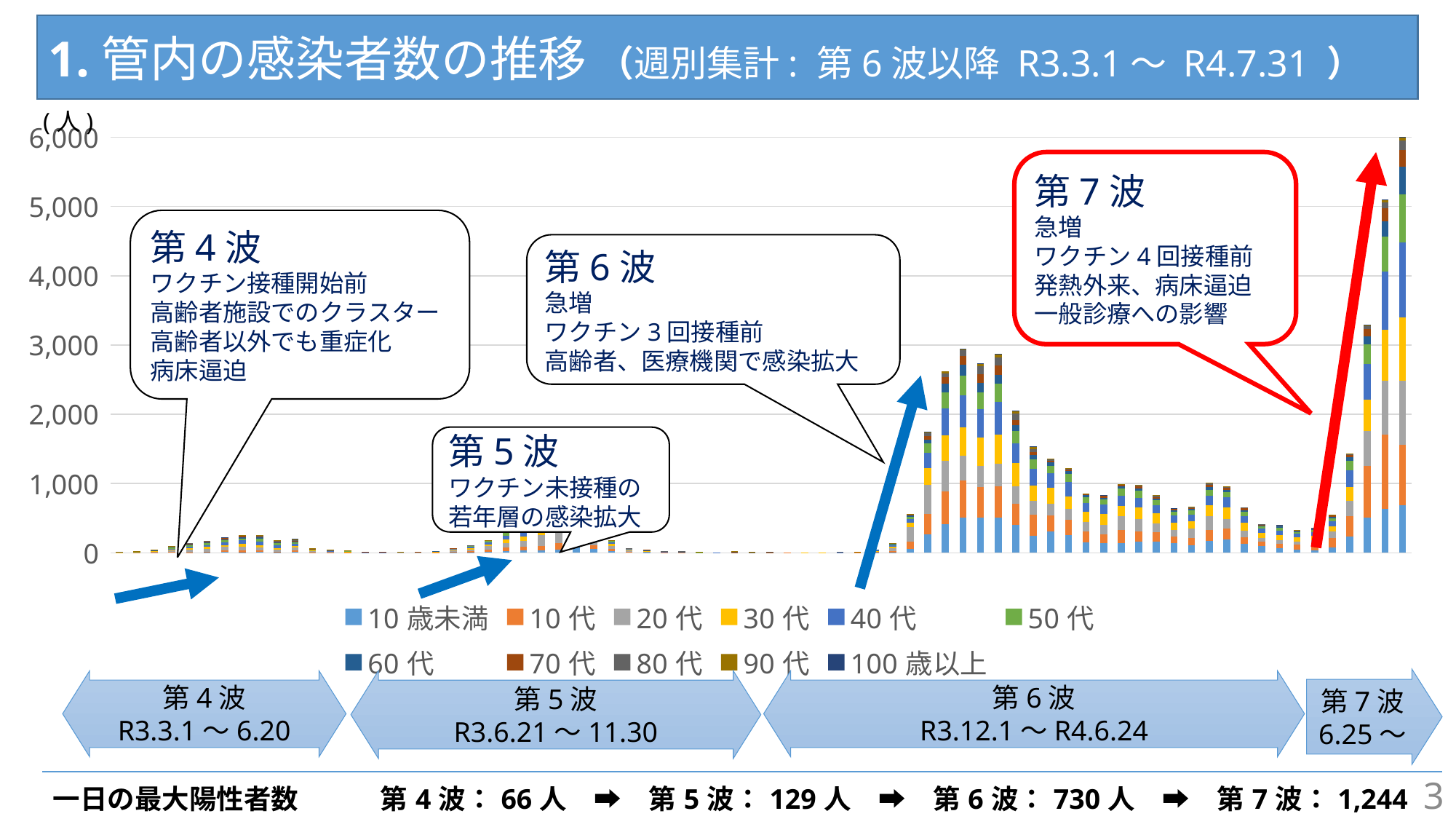
Which age group is listed last in the chart legend? 100歳以上 Is the tallest bar in the 第6波 period greater or less than 4,000? less Which is taller: the highest bar in 第6波 or the highest bar in 第7波? 第7波 How many series does the chart legend list? 11 Which wave period contains the tallest bar in the chart? 第7波 Is the tallest bar in the 第6波 period greater or less than 2,000? greater Which age group is listed first in the chart legend? 10歳未満 What is the highest value shown on the chart's vertical axis? 6,000 Is the tallest bar in the chart (the last bar, in 第7波) greater or less than 5,000? greater What kind of chart is shown on the slide? Stacked bar chart Do the bars rise or fall over the last few weeks at the right end of the chart (第7波)? rise